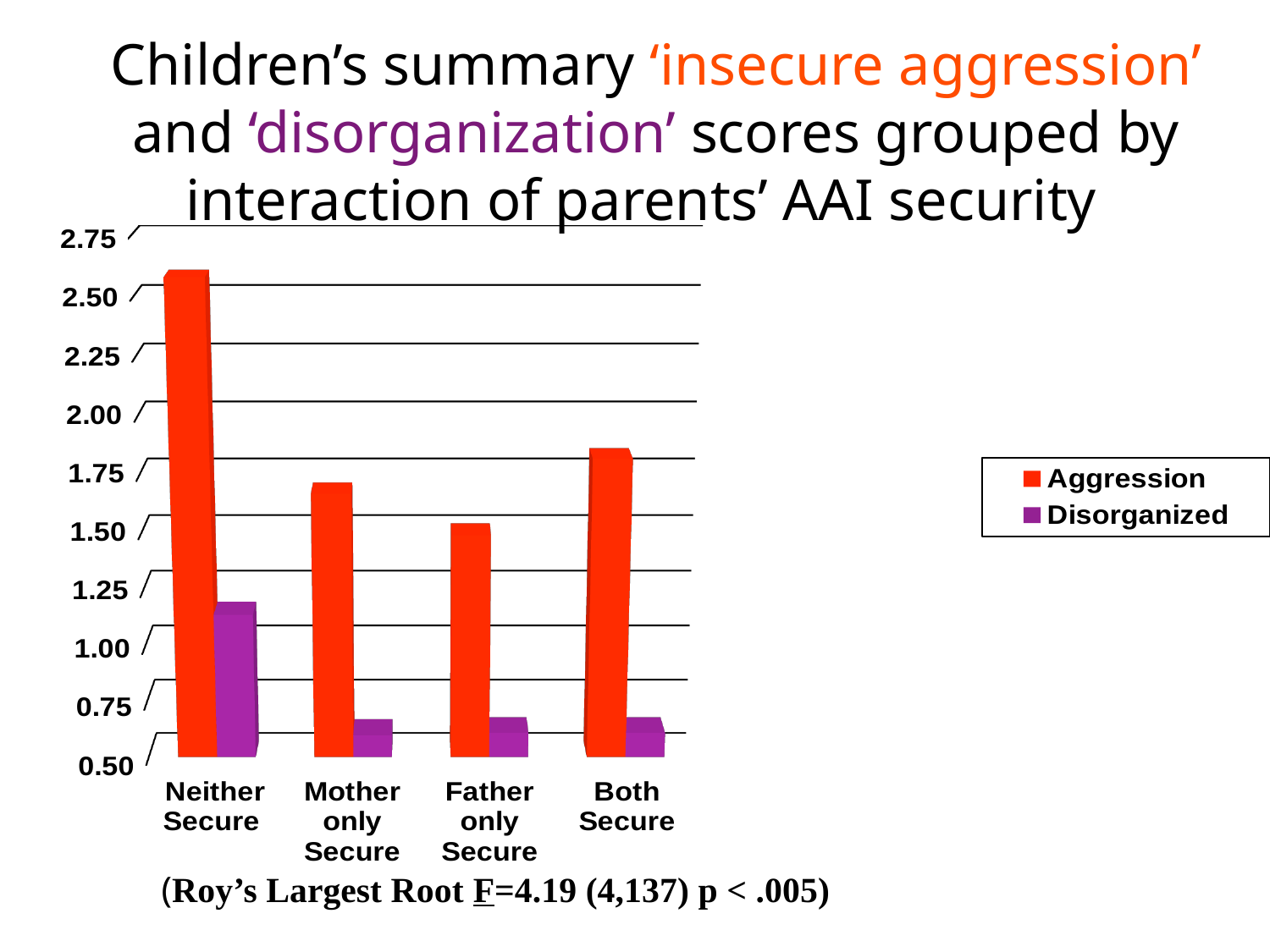
Is the Aggression value for Neither Secure greater or less than 2.50? greater Is the Disorganized value for Mother only Secure greater or less than 0.75? less Which group has the highest Disorganized score? Neither Secure How many parent-security groups are shown on the x axis? 4 Is the Disorganized value for Neither Secure greater or less than 1.00? greater Which group has the highest Aggression score? Neither Secure Which is larger, the Aggression score for Both Secure or for Mother only Secure? Both Secure Which group has the lowest Aggression score? Father only Secure How many series does the legend list? 2 What kind of chart is shown on the slide? bar chart What colour represents the Disorganized series in the legend? purple